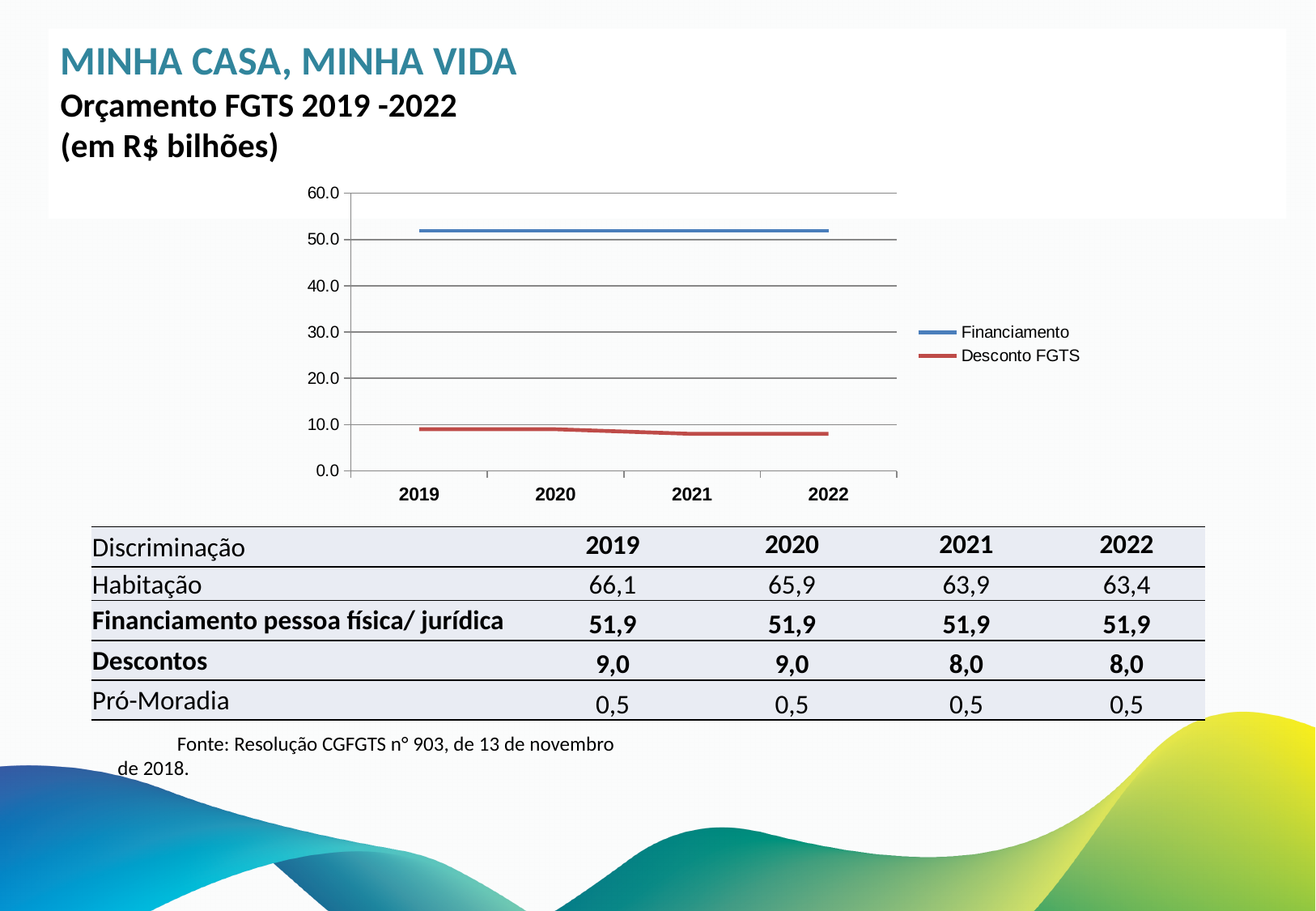
How many series does the chart legend list? 2 What is the unit stated in the slide subtitle for the chart values? R$ bilhões Which series is higher in the chart, Financiamento or Desconto FGTS? Financiamento What colour is the Financiamento line in the chart? blue According to the table, what is the value for Descontos in 2019? 9,0 According to the table, what is the value for Financiamento pessoa física/ jurídica in 2021? 51,9 Is the value for Desconto FGTS in 2022 greater or less than 10.0? less According to the table, what is the difference between Descontos in 2019 and in 2022? 1,0 What kind of chart is shown on the slide? line chart Does the Desconto FGTS line rise or fall from 2019 to 2022? fall How many years are plotted along the x axis of the chart? 4 Is the value for Financiamento in 2019 greater or less than 50.0? greater